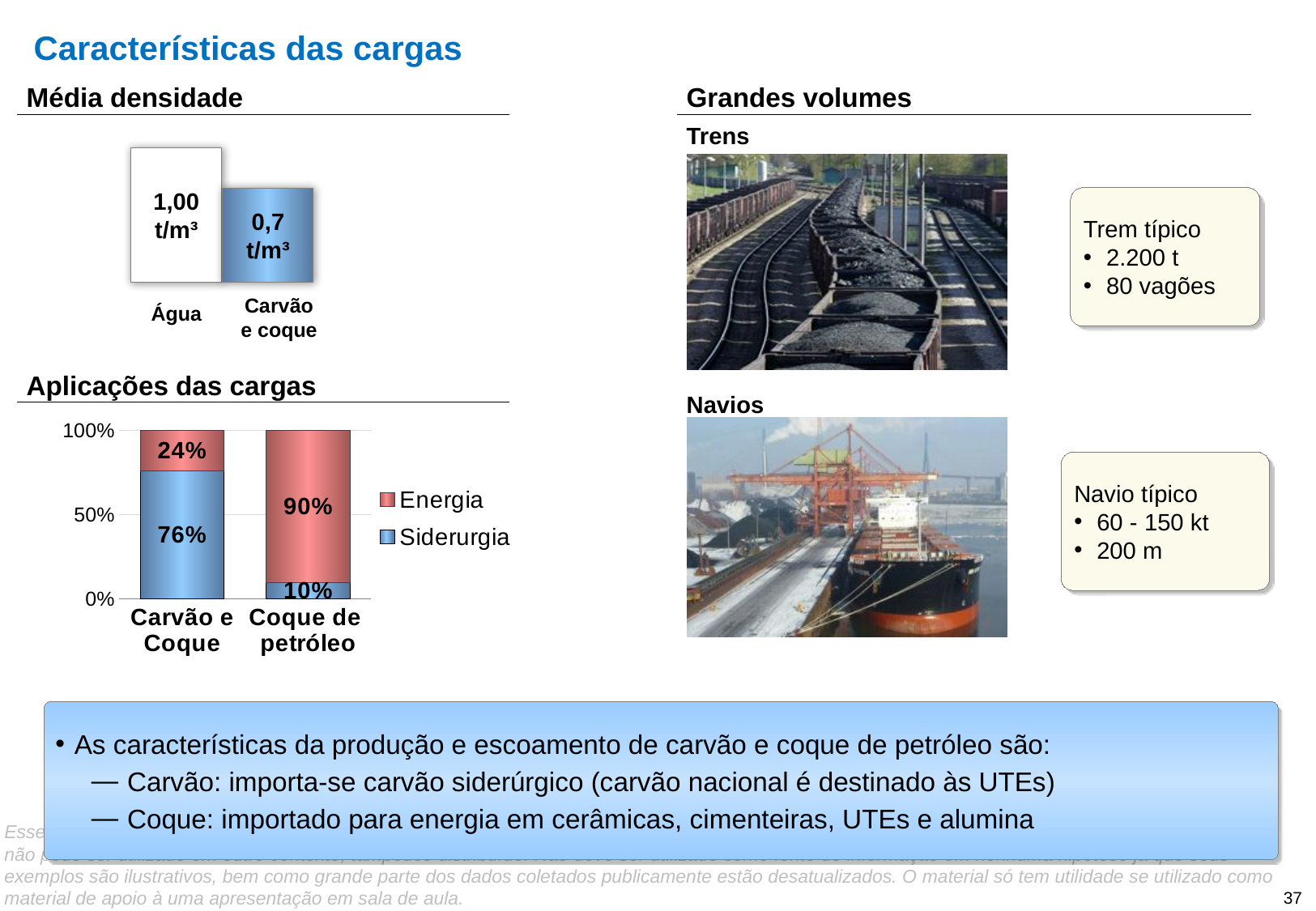
In the 'Média densidade' chart, what is the density value shown for Carvão e coque? 0,7 t/m³ In the 'Aplicações das cargas' chart, which category has the larger Siderurgia share, Carvão e Coque or Coque de petróleo? Carvão e Coque In the 'Média densidade' chart, which category has the higher density, Água or Carvão e coque? Água In the 'Aplicações das cargas' chart, what share of Carvão e Coque goes to Siderurgia? 76% In the 'Aplicações das cargas' chart, what share of Coque de petróleo goes to Siderurgia? 10% What kind of chart is the 'Aplicações das cargas' chart? Stacked bar chart In the 'Aplicações das cargas' chart, how many series does the legend list? 2 In the 'Média densidade' chart, how many categories are shown? 2 In the 'Aplicações das cargas' chart, which colour represents Energia? Red In the 'Aplicações das cargas' chart, what share of Coque de petróleo goes to Energia? 90% In the 'Aplicações das cargas' chart, what is the difference between the Energia share of Coque de petróleo and the Energia share of Carvão e Coque? 66% In the 'Média densidade' chart, what is the density value shown for Água? 1,00 t/m³